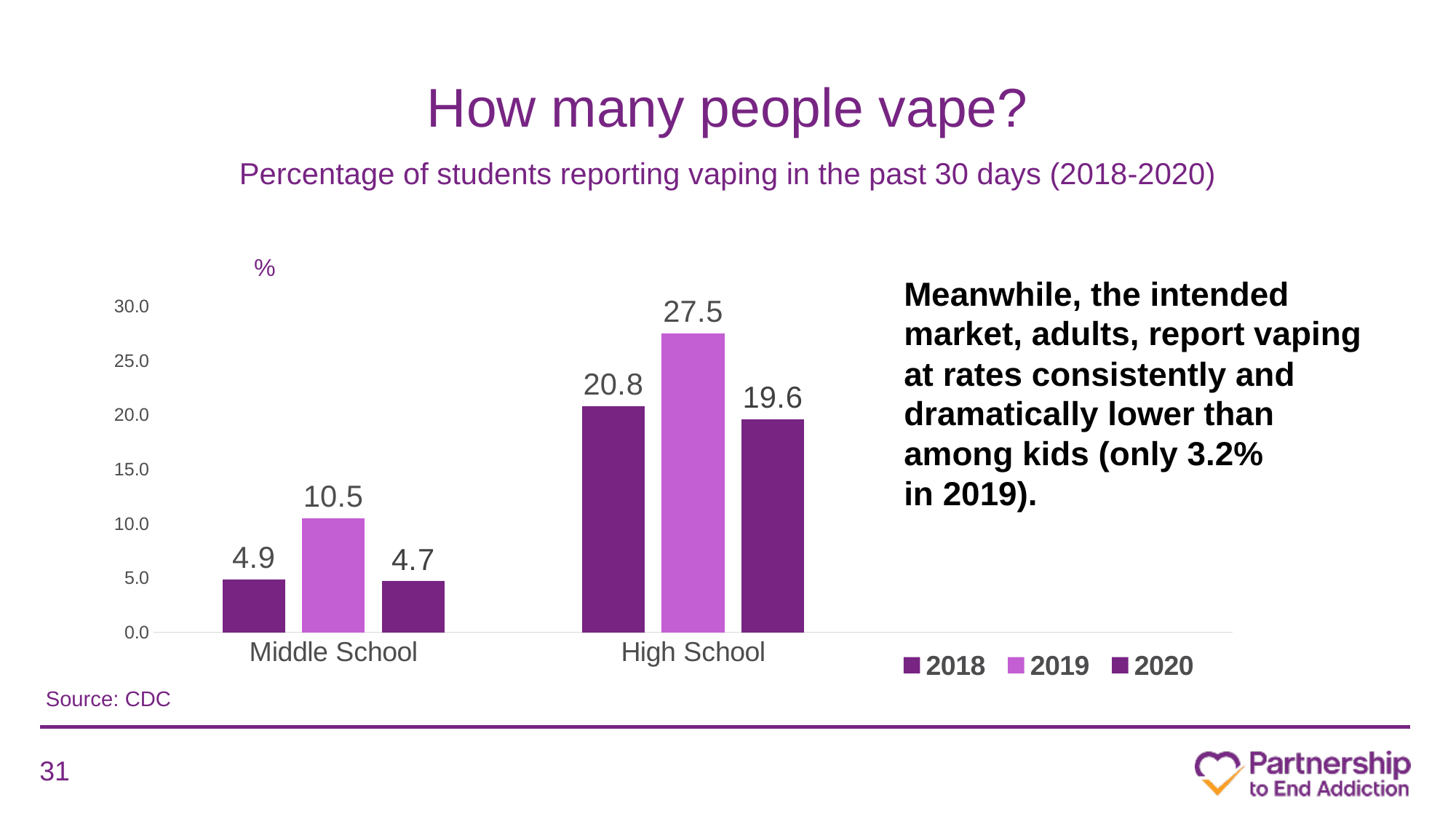
What is the difference between the High School and Middle School values in 2019? 17.0 Which is larger, the Middle School value in 2018 or in 2020? 2018 How many school-level categories are shown on the x axis? 2 How many series does the legend list? 3 What is the difference between the 2019 and 2020 values for High School? 7.9 What kind of chart is shown on the slide? Bar chart What is the source cited for the chart? CDC What is the value for High School in 2018? 20.8 Which year has the lowest value for Middle School? 2020 What percentage of middle school students reported vaping in 2019? 10.5 What percentage of high school students reported vaping in 2020? 19.6 Which year has the highest value for High School? 2019